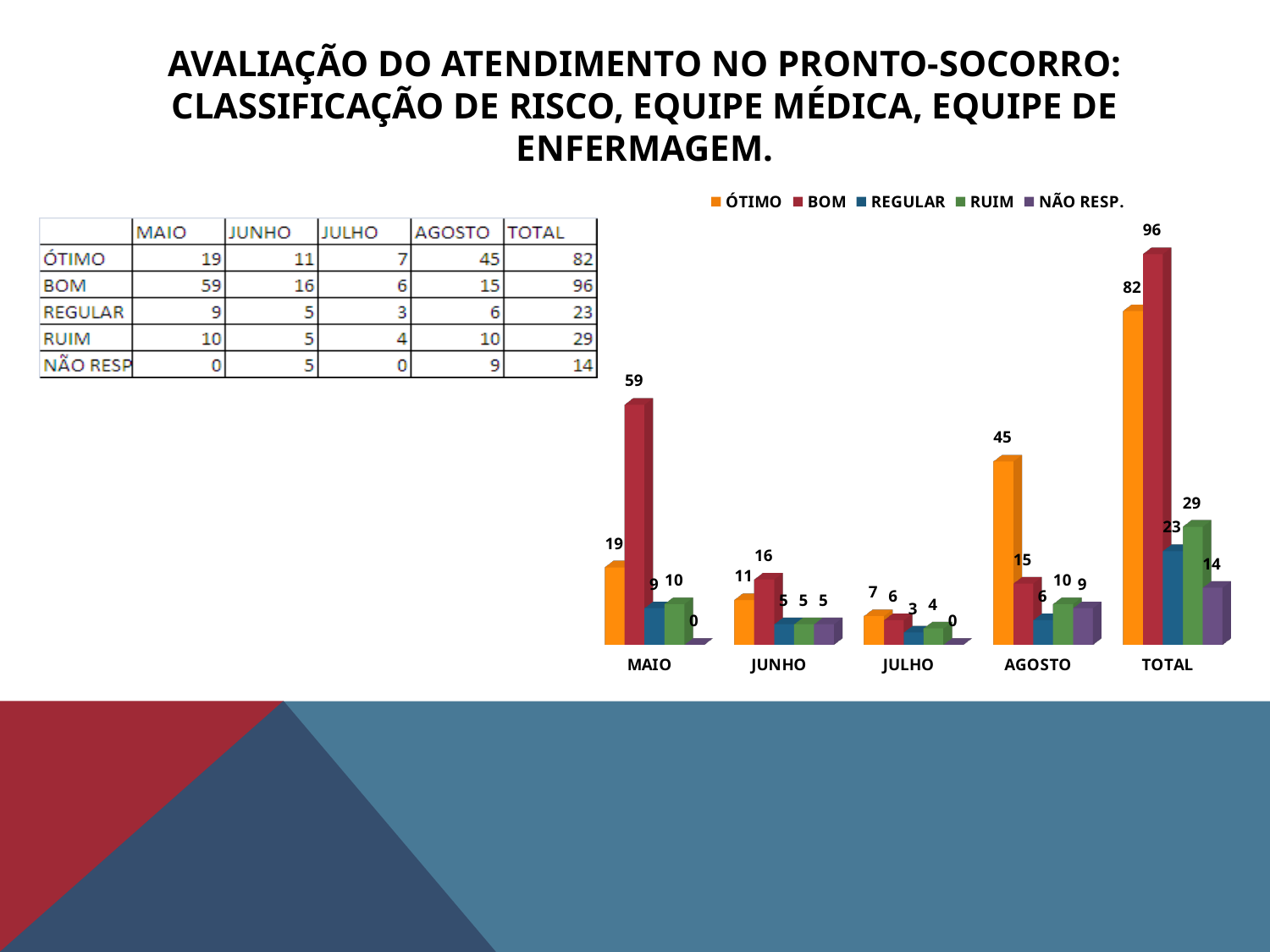
What is the value for ÓTIMO in AGOSTO? 45 Which series has the lowest value in the MAIO category? NÃO RESP. Does the value for ÓTIMO rise or fall from MAIO to JULHO? Fall What is the value for BOM in MAIO? 59 What colour represents the REGULAR series in the chart? Blue How many categories are shown on the x axis? 5 Which series has the highest value in the TOTAL category? BOM What kind of chart is shown on the slide? Bar chart What is the value for NÃO RESP. in JUNHO? 5 What is the difference between the BOM and ÓTIMO values in the TOTAL category? 14 Which is larger in AGOSTO: the value for BOM or the value for RUIM? BOM How many series does the legend list? 5